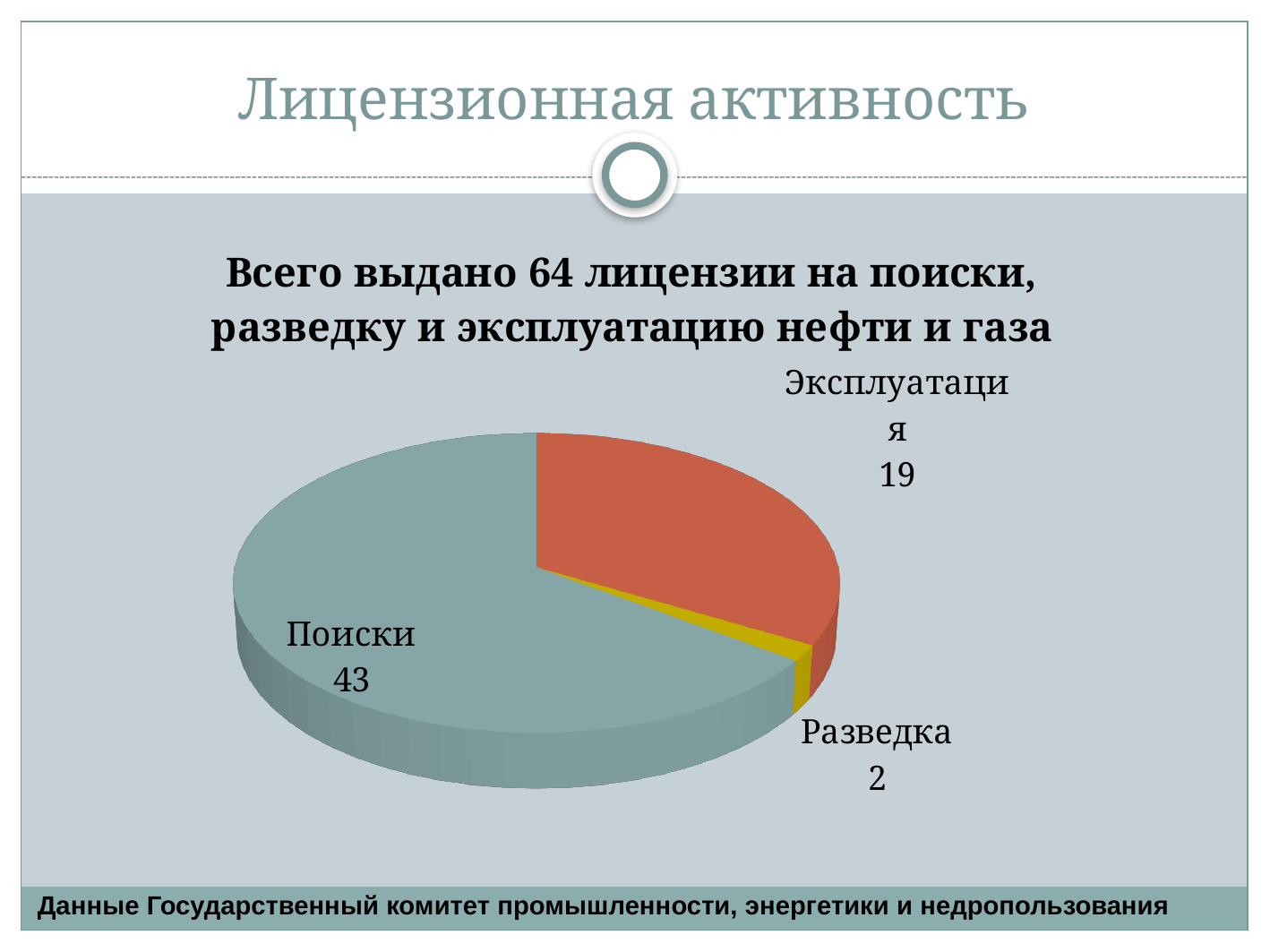
What type of chart is shown on the slide? pie chart What is the difference between the number of licenses for Эксплуатация and for Разведка? 17 What is the difference between the number of licenses for Поиски and for Эксплуатация? 24 Which category has the largest slice of the pie? Поиски How many licenses are shown for Поиски? 43 How many categories does the pie chart have? 3 Which category has the smallest slice of the pie? Разведка How many licenses are shown for Эксплуатация? 19 What is the title of the chart? Всего выдано 64 лицензии на поиски, разведку и эксплуатацию нефти и газа How many licenses are shown for Разведка? 2 Which is larger: the value for Эксплуатация or the value for Разведка? Эксплуатация What is the total number of licenses across all slices of the pie? 64